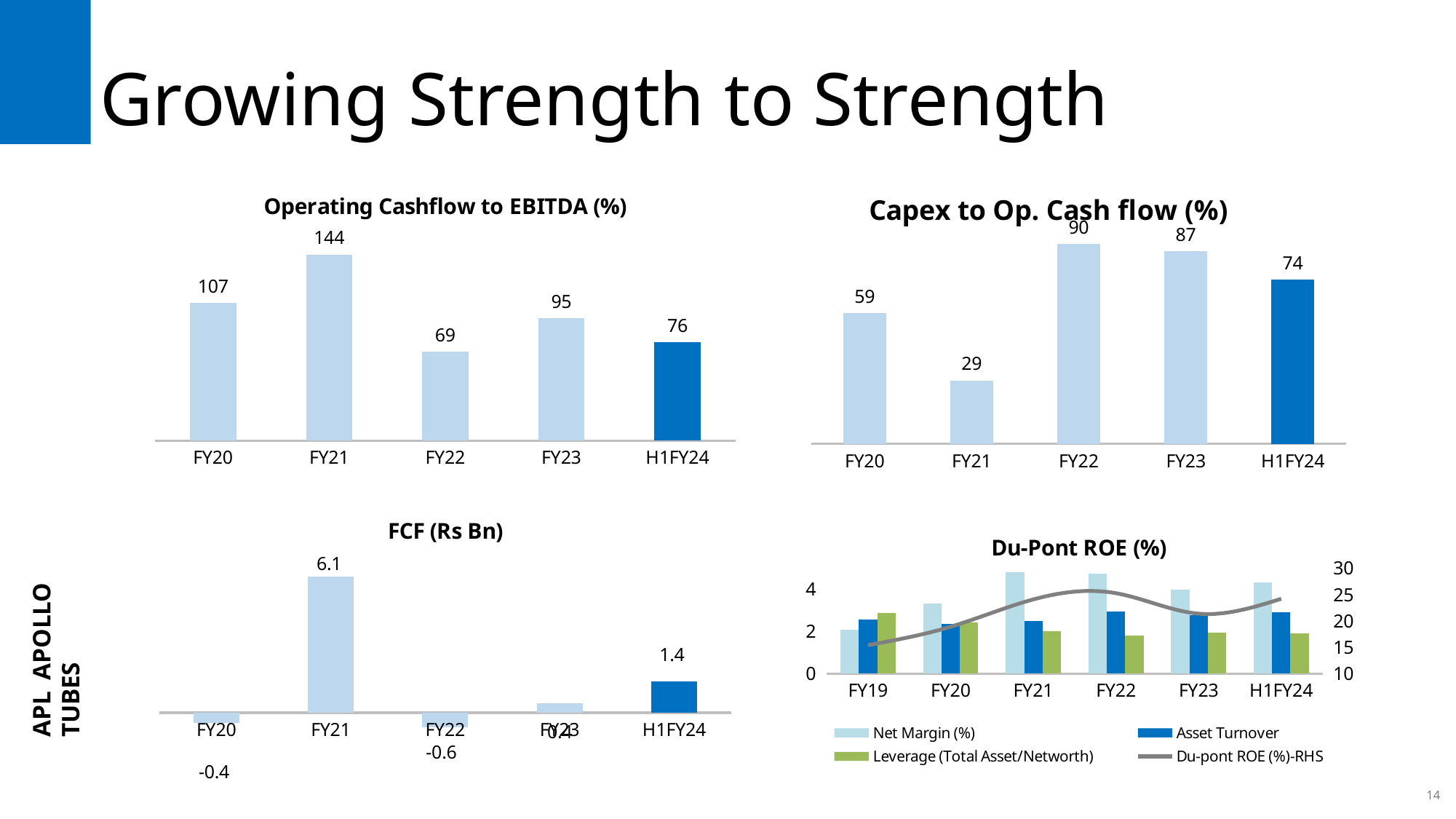
In the FCF (Rs Bn) chart, which period has the lowest value? FY22 In the Operating Cashflow to EBITDA (%) chart, which period has the highest value? FY21 In the Du-Pont ROE (%) chart, how many series does the legend list? 4 In the Capex to Op. Cash flow (%) chart, which period has the lowest value? FY21 In the Operating Cashflow to EBITDA (%) chart, what is the value for FY21? 144 In the FCF (Rs Bn) chart, what is the value for FY21? 6.1 In the Capex to Op. Cash flow (%) chart, what is the difference between FY22 and FY23? 3 In the Du-Pont ROE (%) chart, how many periods are shown on the x axis? 6 In the Capex to Op. Cash flow (%) chart, what is the value for H1FY24? 74 In the Du-Pont ROE (%) chart, is the Net Margin (%) value for FY21 greater or less than 4? greater In the Operating Cashflow to EBITDA (%) chart, which is larger, FY20 or FY23? FY20 In the Operating Cashflow to EBITDA (%) chart, what is the difference between FY21 and FY22? 75